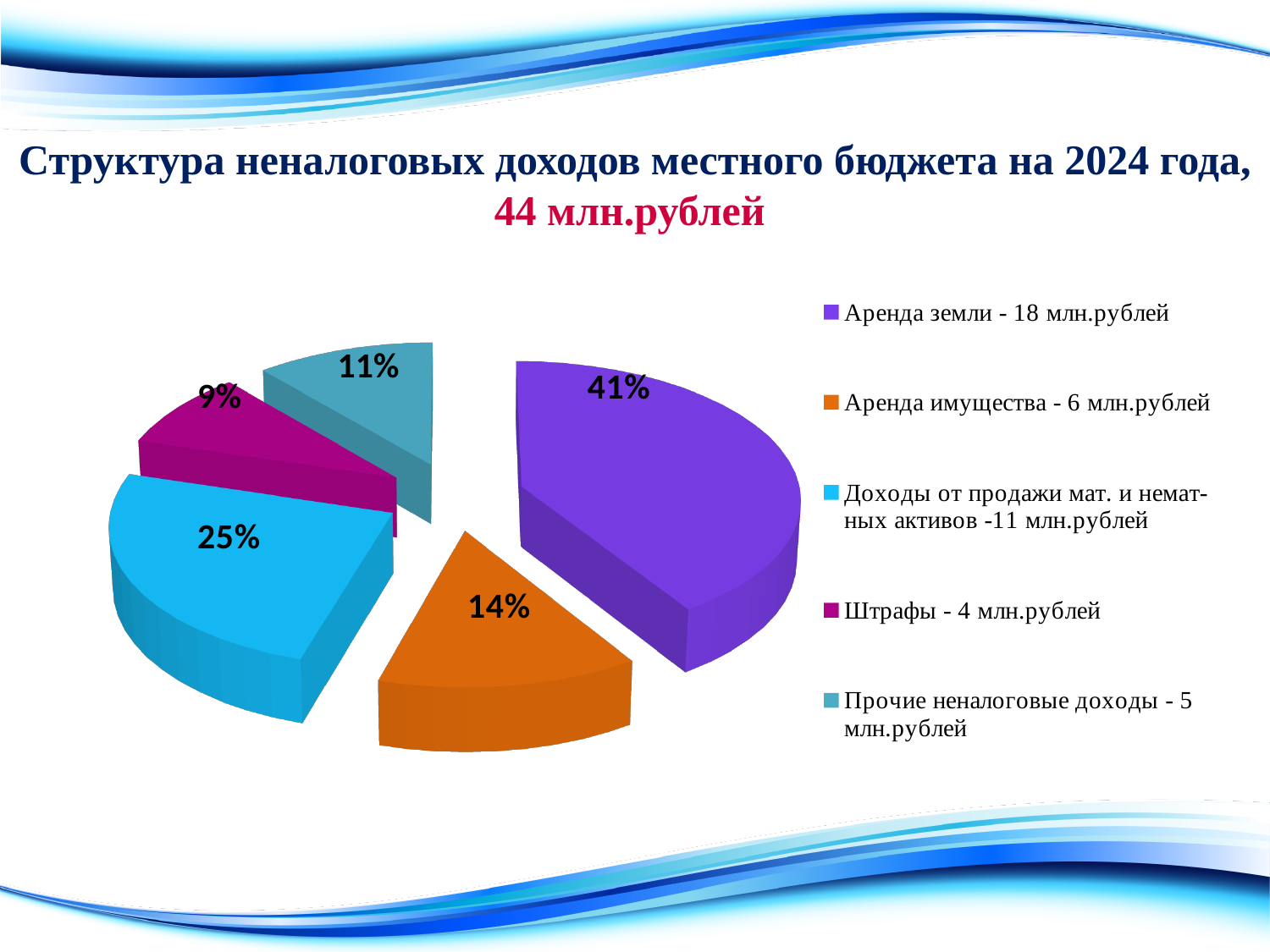
What is the difference in percentage points between the Аренда земли slice and the Доходы от продажи мат. и немат-ных активов slice? 16 What share of the pie does Аренда имущества take? 14% What share of the pie does Аренда земли take? 41% What share of the pie does Штрафы take? 9% Which category has the largest slice of the pie? Аренда земли Which category has the smallest slice of the pie? Штрафы What kind of chart is shown on the slide? pie chart According to the legend, how many million rubles does Аренда земли amount to? 18 млн.рублей Which slice is larger: Аренда имущества or Прочие неналоговые доходы? Аренда имущества How many slices does the pie chart have? 5